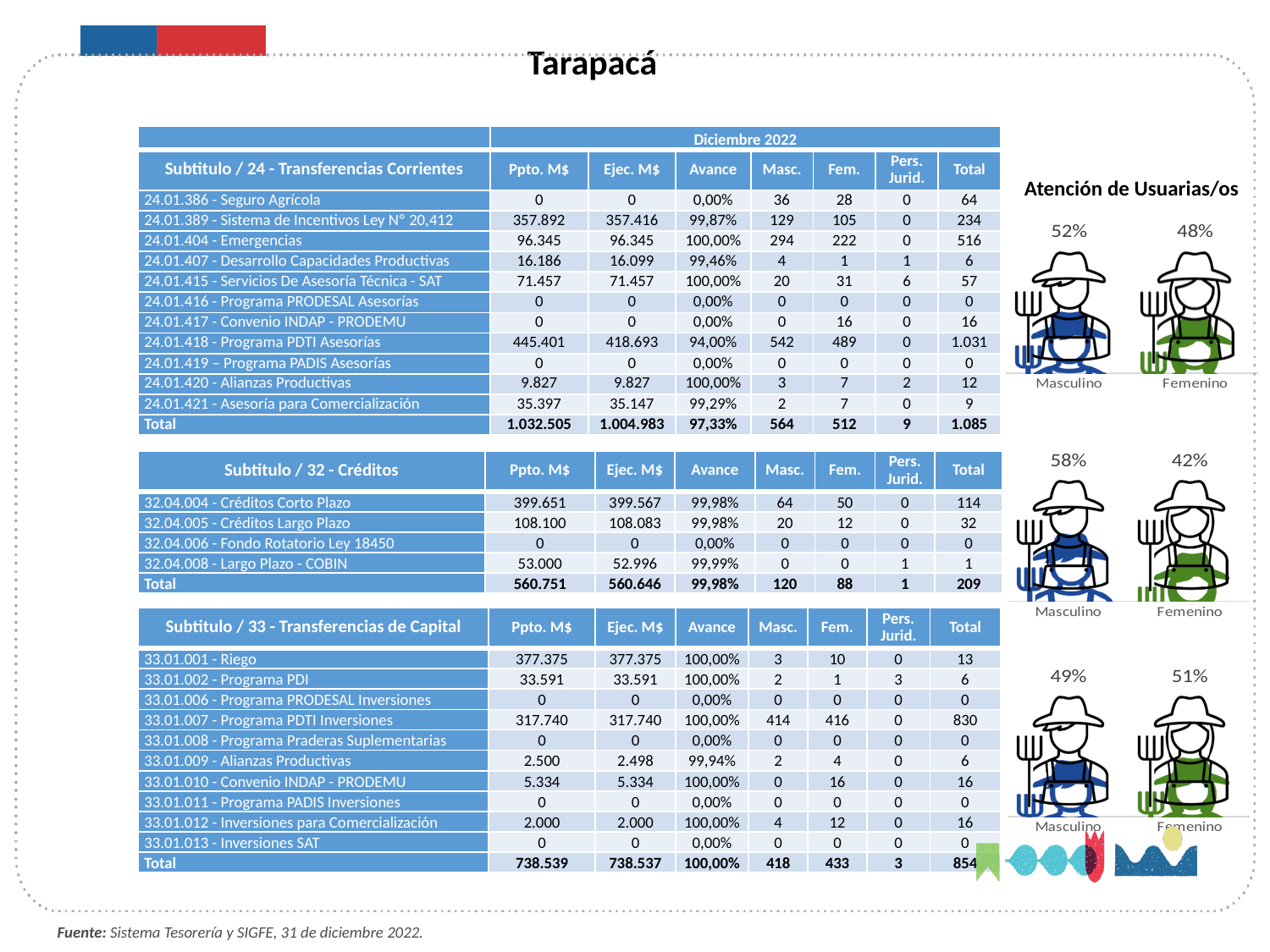
In the middle pictogram on the right side of the slide, what percentage is shown for Femenino? 42% In the middle pictogram on the right side of the slide, what is the difference between the Masculino and Femenino percentages? 16% In the pictograms on the right side of the slide, what colour is the Femenino figure's clothing? Green In the bottom pictogram on the right side of the slide, which is larger, Masculino or Femenino? Femenino What is the title above the pictograms on the right side of the slide? Atención de Usuarias/os How many categories does each pictogram on the right side of the slide show? 2 In the top 'Atención de Usuarias/os' pictogram, what percentage is shown for Femenino? 48% In the top 'Atención de Usuarias/os' pictogram, what is the difference between the Masculino and Femenino percentages? 4% In the bottom pictogram on the right side of the slide, what percentage is shown for Femenino? 51% In the top 'Atención de Usuarias/os' pictogram, what percentage is shown for Masculino? 52% In the middle pictogram on the right side of the slide, what percentage is shown for Masculino? 58%